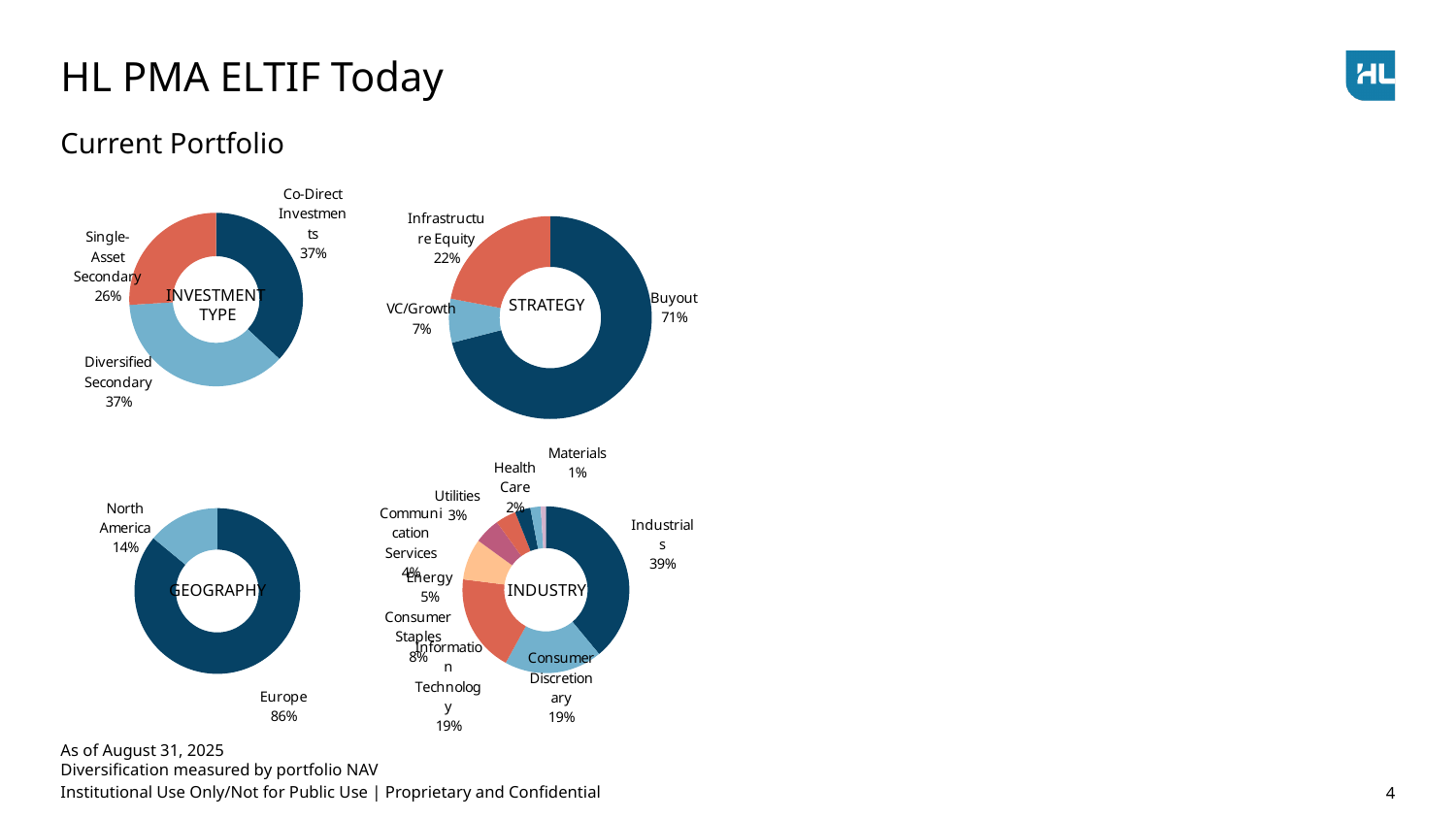
In the STRATEGY chart, what is the difference between the Buyout share and the Infrastructure Equity share? 49 percentage points In the INDUSTRY chart, which industry has the smallest share? Materials In the STRATEGY chart, what share does Buyout represent? 71% In the GEOGRAPHY chart, what share does North America represent? 14% How many industries are shown in the INDUSTRY chart? 9 In the INVESTMENT TYPE chart, what share does Single-Asset Secondary represent? 26% In the INDUSTRY chart, which industry has the largest share? Industrials In the INVESTMENT TYPE chart, which is larger: Diversified Secondary or Single-Asset Secondary? Diversified Secondary What type of chart is the GEOGRAPHY chart? Donut (pie) chart In the INDUSTRY chart, what share does Consumer Staples represent? 8% In the GEOGRAPHY chart, what is the difference between the Europe share and the North America share? 72 percentage points In the STRATEGY chart, which strategy has the smallest share? VC/Growth